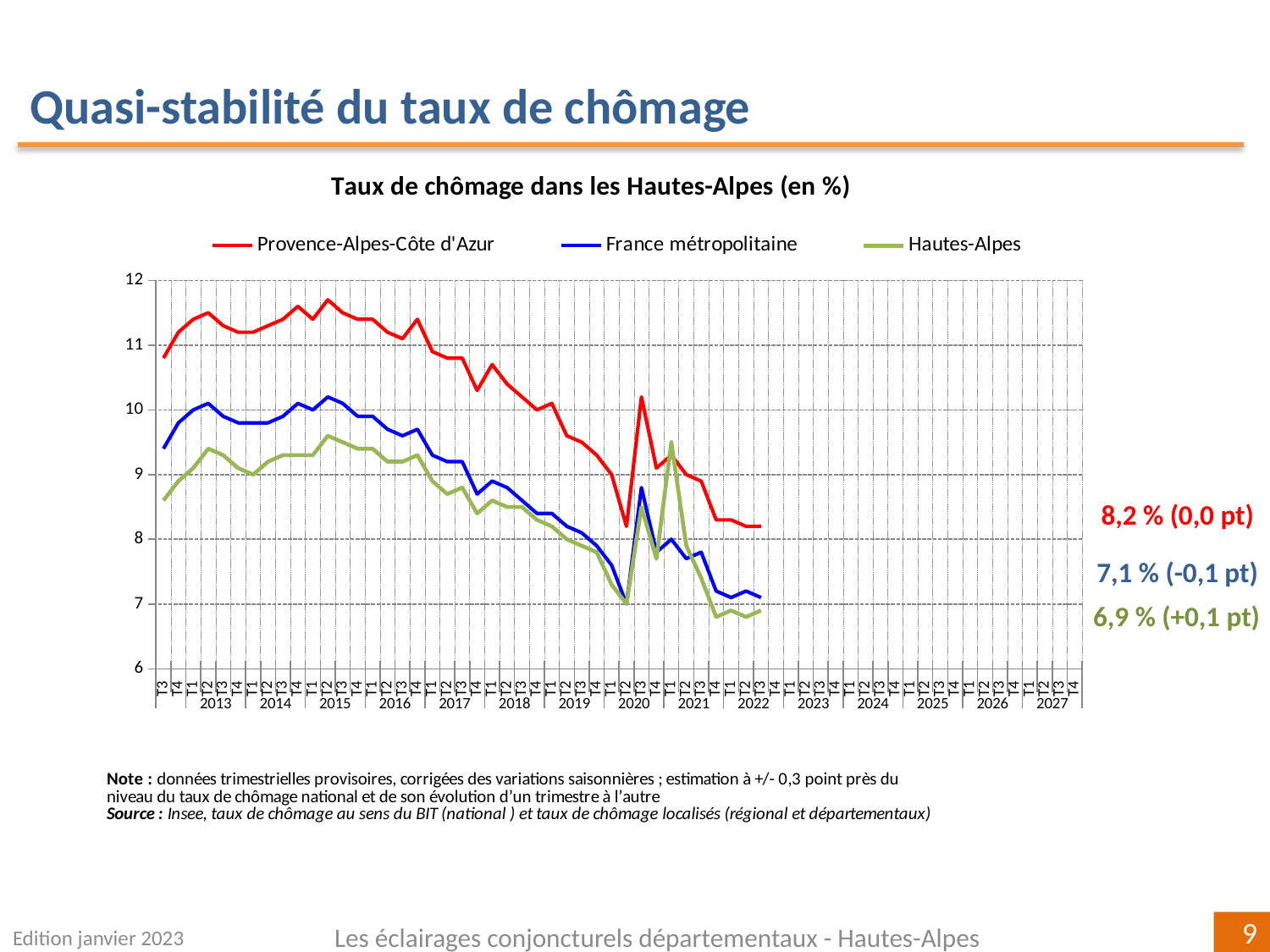
What is the latest unemployment rate shown for Hautes-Alpes? 6,9 % What colour is the Hautes-Alpes line? green What kind of chart is shown on the slide? line chart What quarterly change is shown next to the latest Hautes-Alpes value? +0,1 pt Does the Provence-Alpes-Côte d'Azur series overall rise or fall between 2013 and 2022? fall How many series does the legend list? 3 Is the value for Provence-Alpes-Côte d'Azur in T2 2015 greater or less than 11? greater Which series has the lowest value at the end of the chart? Hautes-Alpes What is the latest unemployment rate shown for France métropolitaine? 7,1 % What is the difference between the latest values for Provence-Alpes-Côte d'Azur and Hautes-Alpes? 1,3 points What is the latest unemployment rate shown for Provence-Alpes-Côte d'Azur? 8,2 % Which series has the highest value at the end of the chart? Provence-Alpes-Côte d'Azur